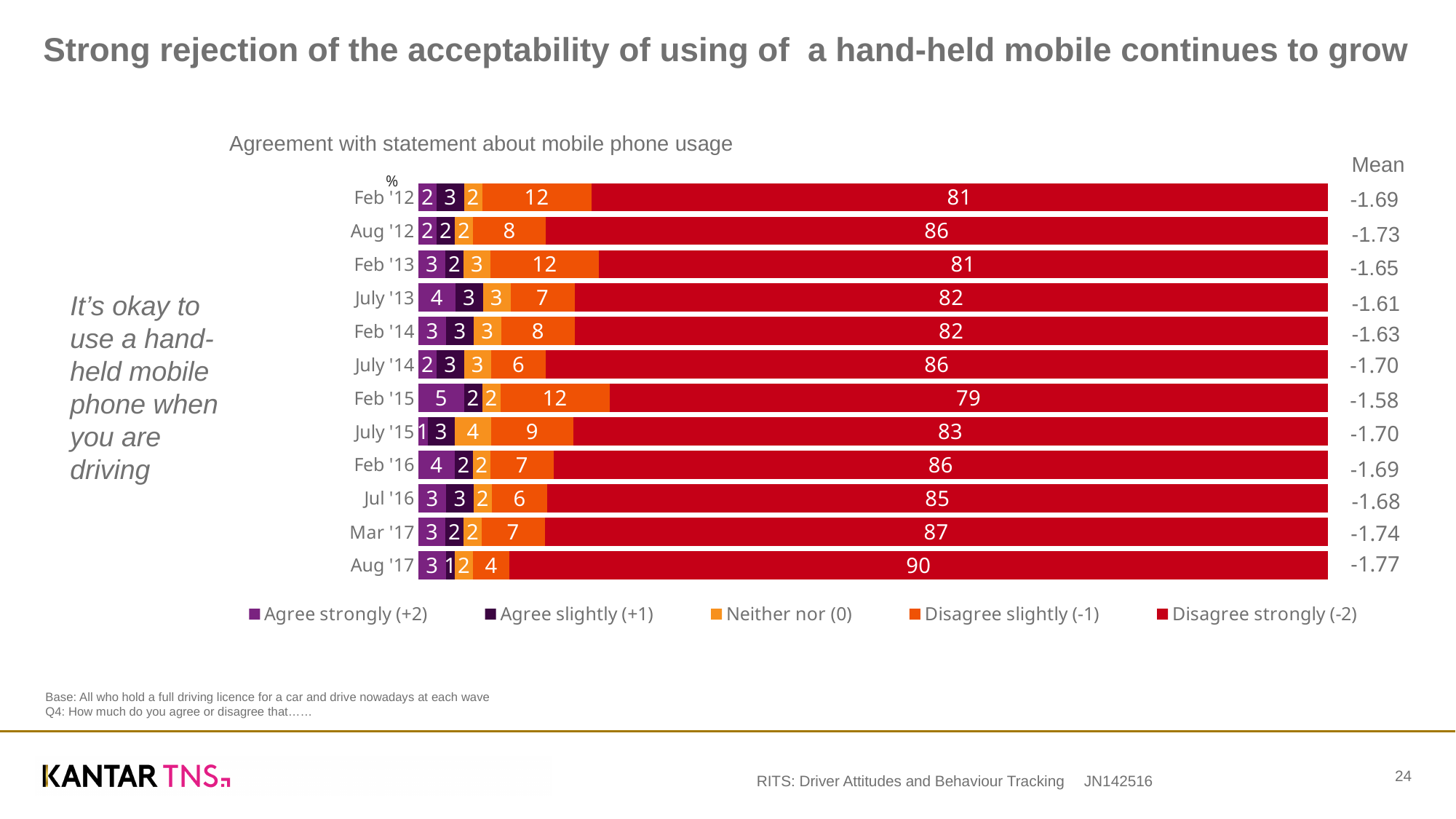
What is the Agree strongly (+2) value for Feb '15? 5 Which wave has the larger Disagree slightly (-1) value, Feb '13 or July '13? Feb '13 How many series does the legend list? 5 What is the Disagree slightly (-1) value for Feb '15? 12 What is the total of the stacked bar for Feb '12? 100 What is the difference between the Disagree strongly (-2) values for Aug '17 and Feb '12? 9 What is the first entry listed in the chart legend? Agree strongly (+2) What is the Disagree strongly (-2) value for Aug '17? 90 Which wave has the lowest Disagree strongly (-2) value? Feb '15 Which wave has the highest Disagree strongly (-2) value? Aug '17 How many survey waves (bars) are shown in the chart? 12 What kind of chart is shown on the slide? bar chart